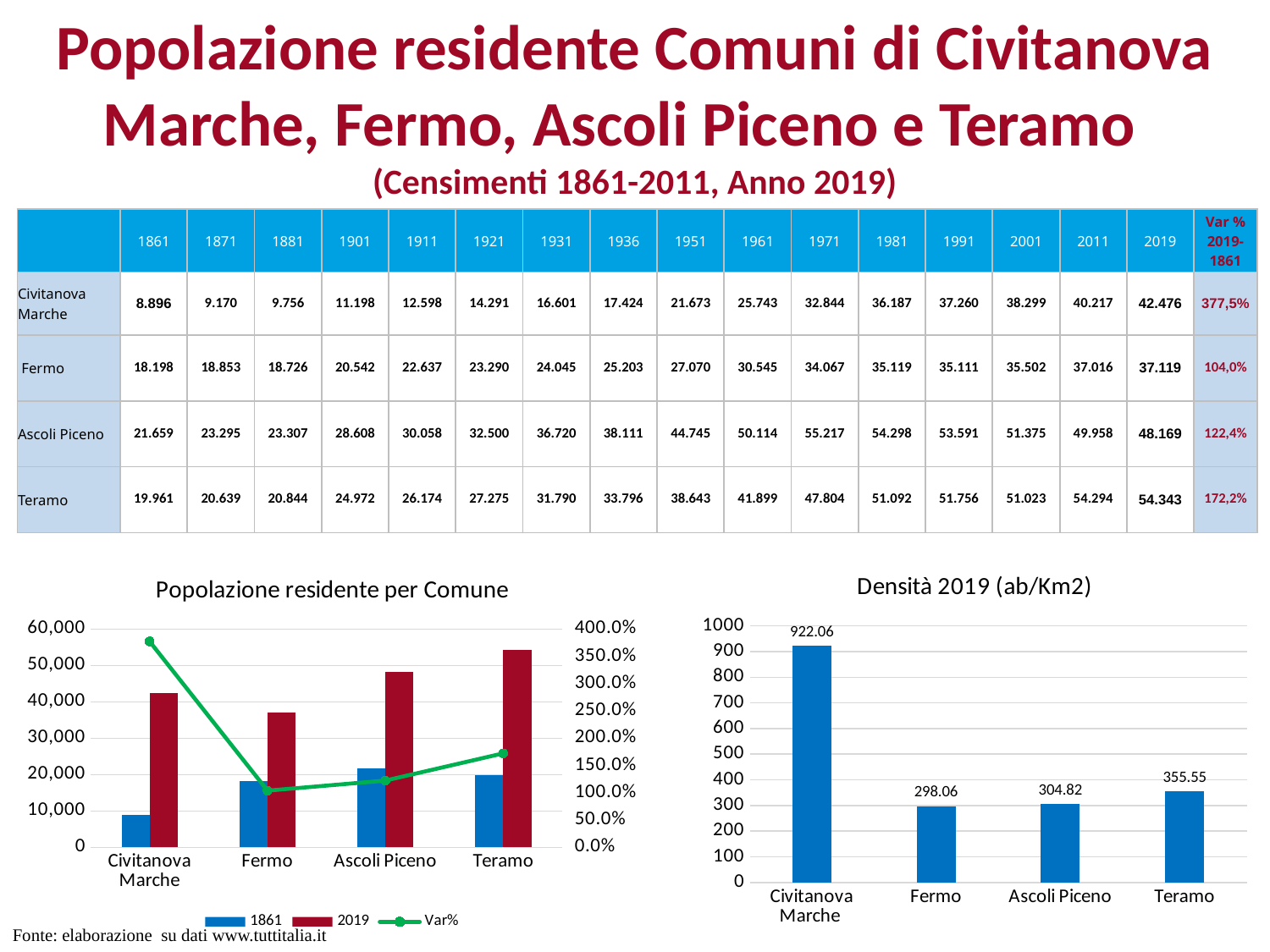
In the 'Densità 2019 (ab/Km2)' chart, what is the value for Teramo? 355.55 In the 'Popolazione residente per Comune' chart, how many series does the legend list? 3 In the 'Densità 2019 (ab/Km2)' chart, which comune has the highest density? Civitanova Marche In the 'Popolazione residente per Comune' chart, which colour represents the 2019 series in the legend? Dark red What kind of chart is 'Densità 2019 (ab/Km2)'? Bar chart In the 'Densità 2019 (ab/Km2)' chart, how many comuni are shown? 4 In the 'Popolazione residente per Comune' chart, which comune has the highest Var% point? Civitanova Marche In the 'Popolazione residente per Comune' chart, is the 2019 bar for Teramo greater or less than 50,000? greater In the 'Densità 2019 (ab/Km2)' chart, which comune has the lowest density? Fermo In the 'Popolazione residente per Comune' chart, is the 1861 bar for Civitanova Marche greater or less than 10,000? less In the 'Densità 2019 (ab/Km2)' chart, what is the difference between the values for Teramo and Fermo? 57.49 In the 'Densità 2019 (ab/Km2)' chart, what is the value for Civitanova Marche? 922.06